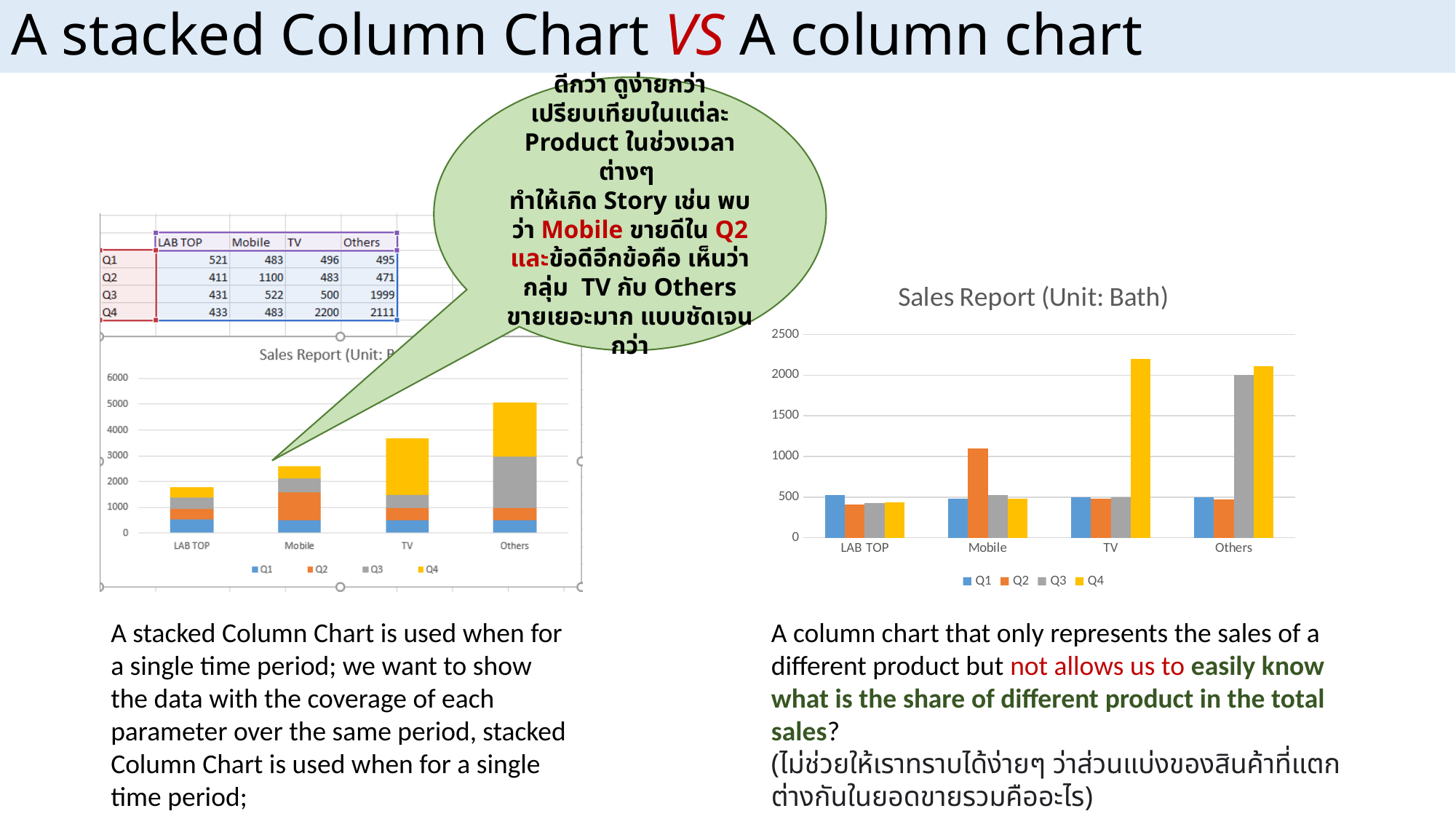
In the left-hand stacked chart, is the total stacked value for Mobile greater or less than 3000? less How many product categories are shown on the x axis of the right-hand chart? 4 In the right-hand chart, which is larger: the Q2 value for Mobile or the Q2 value for TV? Mobile How many series does the legend of the right-hand chart list? 4 What kind of chart is the chart on the right of the slide? bar chart In the left-hand stacked chart, which category has the shortest stacked bar? LAB TOP In the right-hand chart, is the Q1 value for LAB TOP greater or less than 1000? less What is the title of the right-hand chart? Sales Report (Unit: Bath) In the right-hand chart, is the Q4 value for TV greater or less than 2000? greater What kind of chart is the chart on the left of the slide? stacked bar chart In the right-hand chart, which category has the highest Q2 value? Mobile In the left-hand stacked chart, which category has the tallest stacked bar? Others